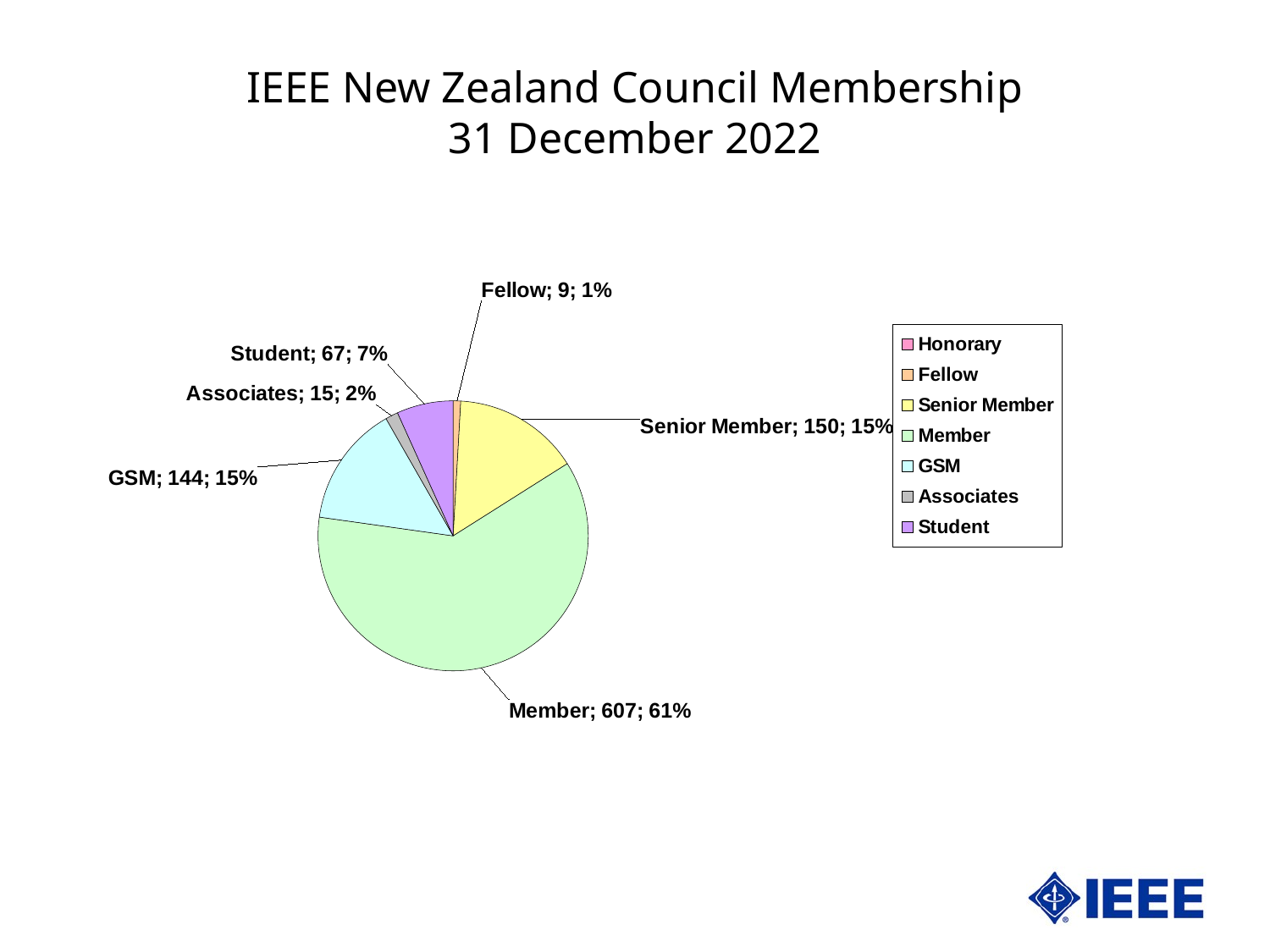
What percentage share does the Student slice have? 7% How many categories does the legend list? 7 What percentage share does the Member slice have? 61% What kind of chart is shown on the slide? pie chart What is the count for Senior Member? 150 Which is larger, the count for Senior Member or the count for GSM? Senior Member What is the title of the slide? IEEE New Zealand Council Membership 31 December 2022 Which category has the largest slice of the pie? Member What is the count for GSM? 144 What is the difference between the Senior Member count and the GSM count? 6 How many members are in the Member category? 607 What is the difference between the Member count and the Senior Member count? 457